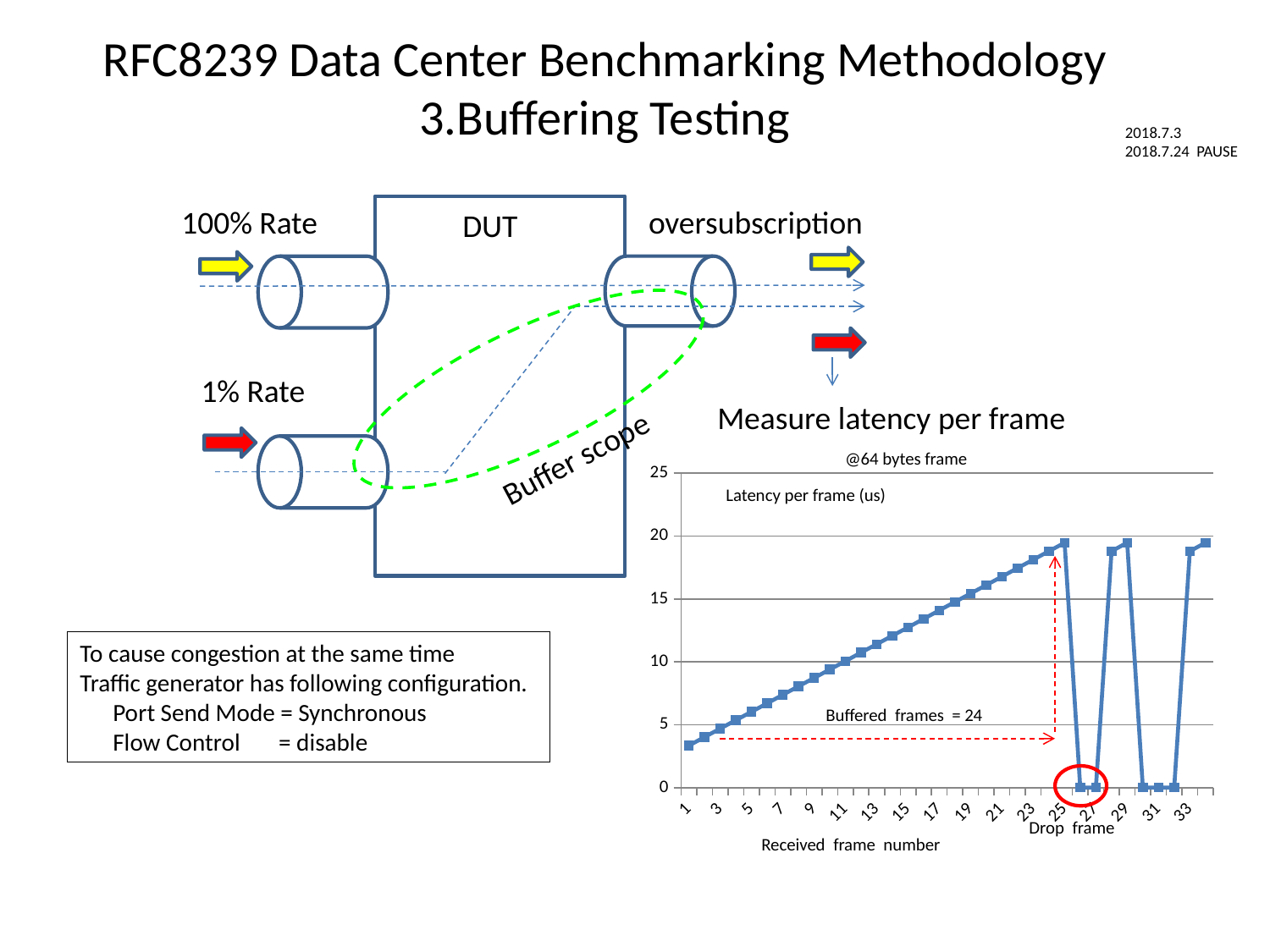
What is the title of the x axis of the chart? Received frame number Is the latency for received frame number 17 greater or less than 15? less Is the latency for received frame number 1 greater or less than 5? less What kind of chart is shown on the slide? line chart Does the latency rise or fall as the received frame number goes from 1 to 25? rises Which has the higher latency: received frame number 25 or received frame number 27? received frame number 25 What is the latency value plotted for received frame number 27? 0 Is the latency for received frame number 21 greater or less than 15? greater What quantity does the chart plot, according to the label inside the plot area? Latency per frame (us) What is the highest value shown on the y axis of the chart? 25